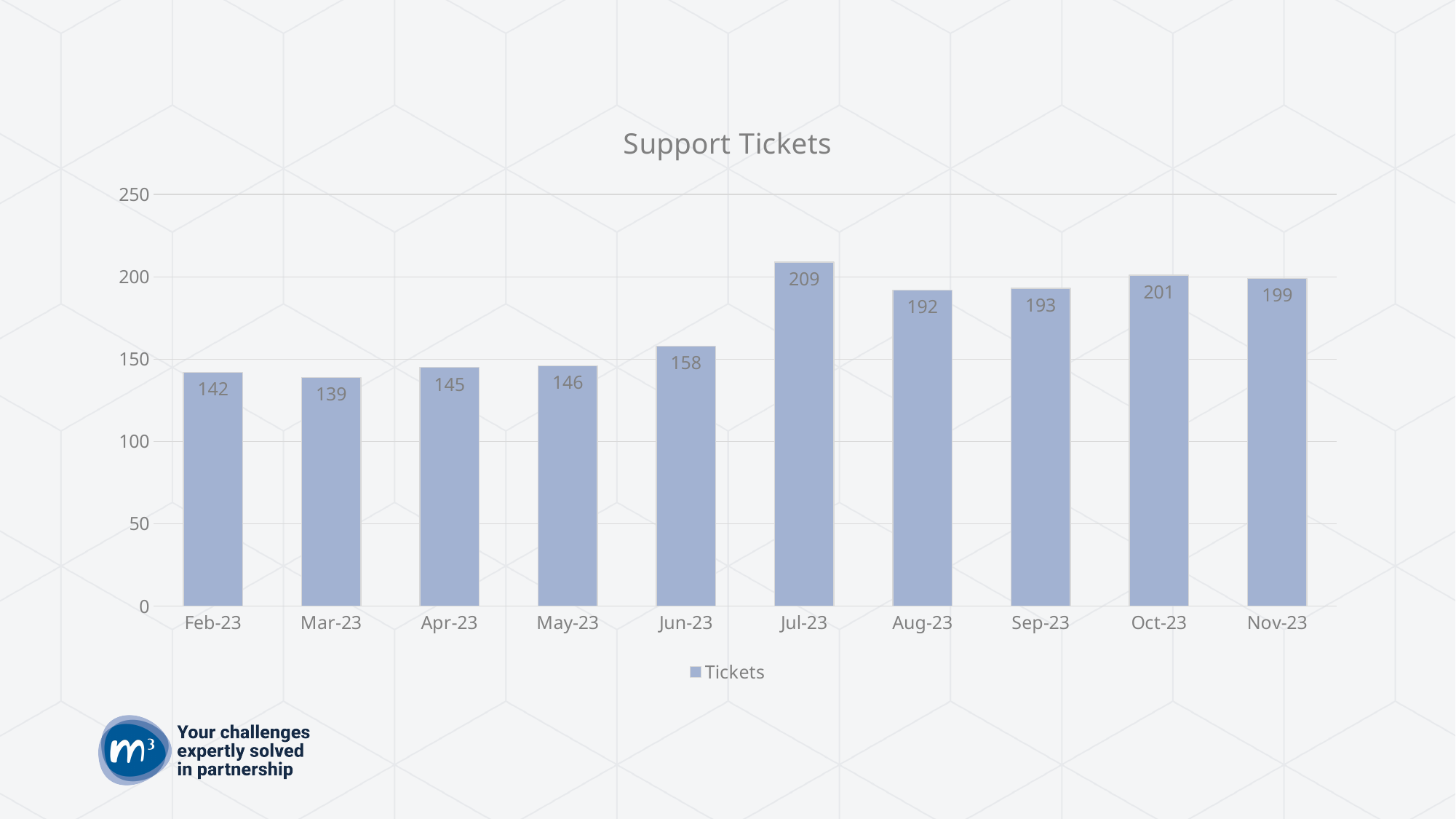
What is the value for Jul-23? 209 What is the value for Feb-23? 142 What kind of chart is shown? bar chart Which month has the highest number of tickets? Jul-23 Which month has the lowest number of tickets? Mar-23 What is the difference between the values for Jul-23 and Jun-23? 51 How many series does the legend list? 1 What is the title of the chart? Support Tickets How many months are shown on the x axis? 10 Is the value for Aug-23 greater or less than 150? greater Which is larger, the value for Oct-23 or the value for Nov-23? Oct-23 What is the value for Sep-23? 193